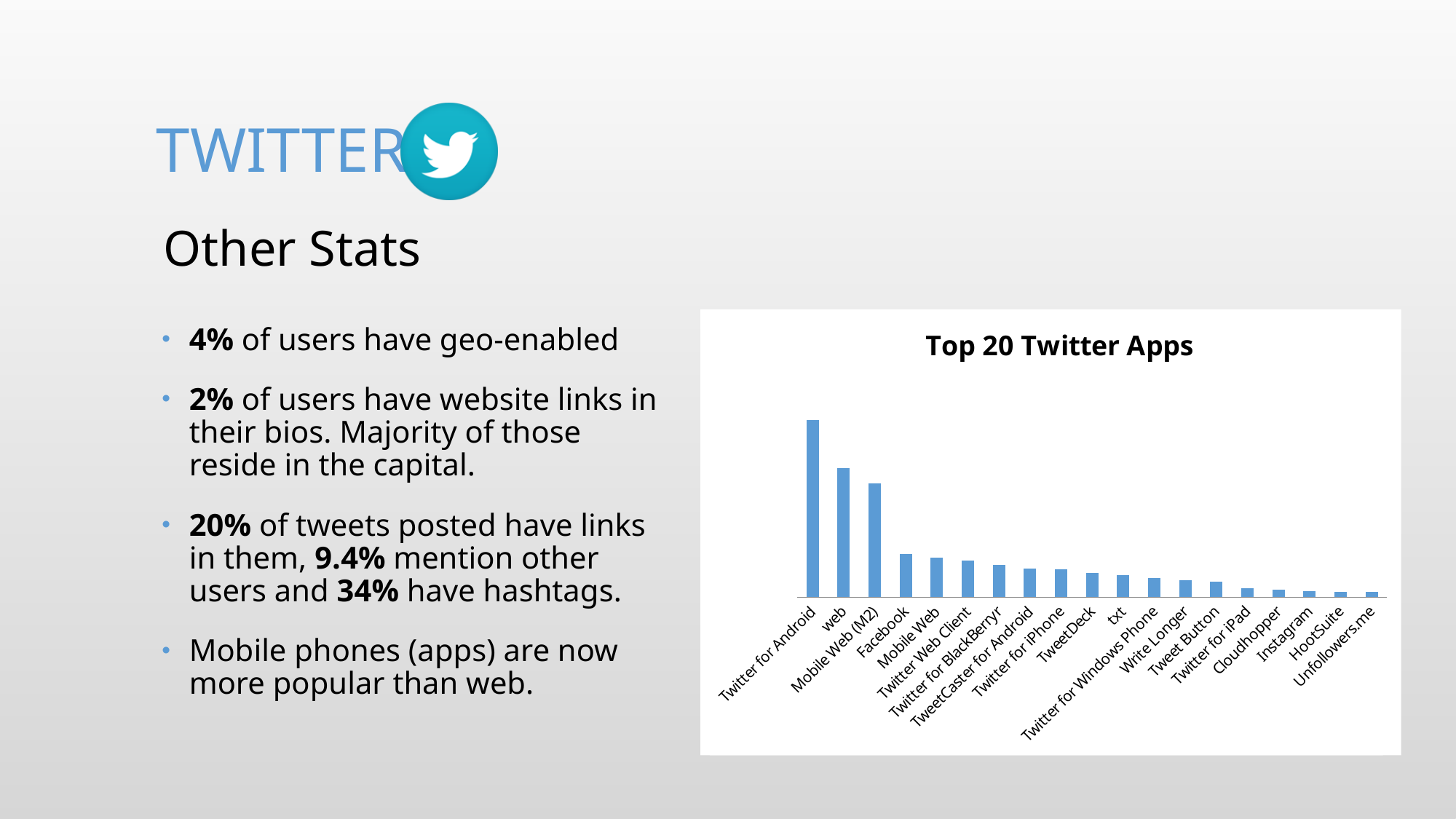
Which has a higher value in the chart, Facebook or Twitter for iPad? Facebook How many apps (bars) are plotted in the chart? 19 What type of chart is shown on the slide? Bar chart Which app is the second highest in the chart? web What is the title of the chart on the slide? Top 20 Twitter Apps What colour are the bars in the chart? Blue Which app has the highest bar in the Top 20 Twitter Apps chart? Twitter for Android Which has a higher value in the chart, Twitter for Android or web? Twitter for Android Which has a higher value in the chart, Mobile Web (M2) or Facebook? Mobile Web (M2) Do the bar values rise or fall moving from left to right along the x axis? Fall